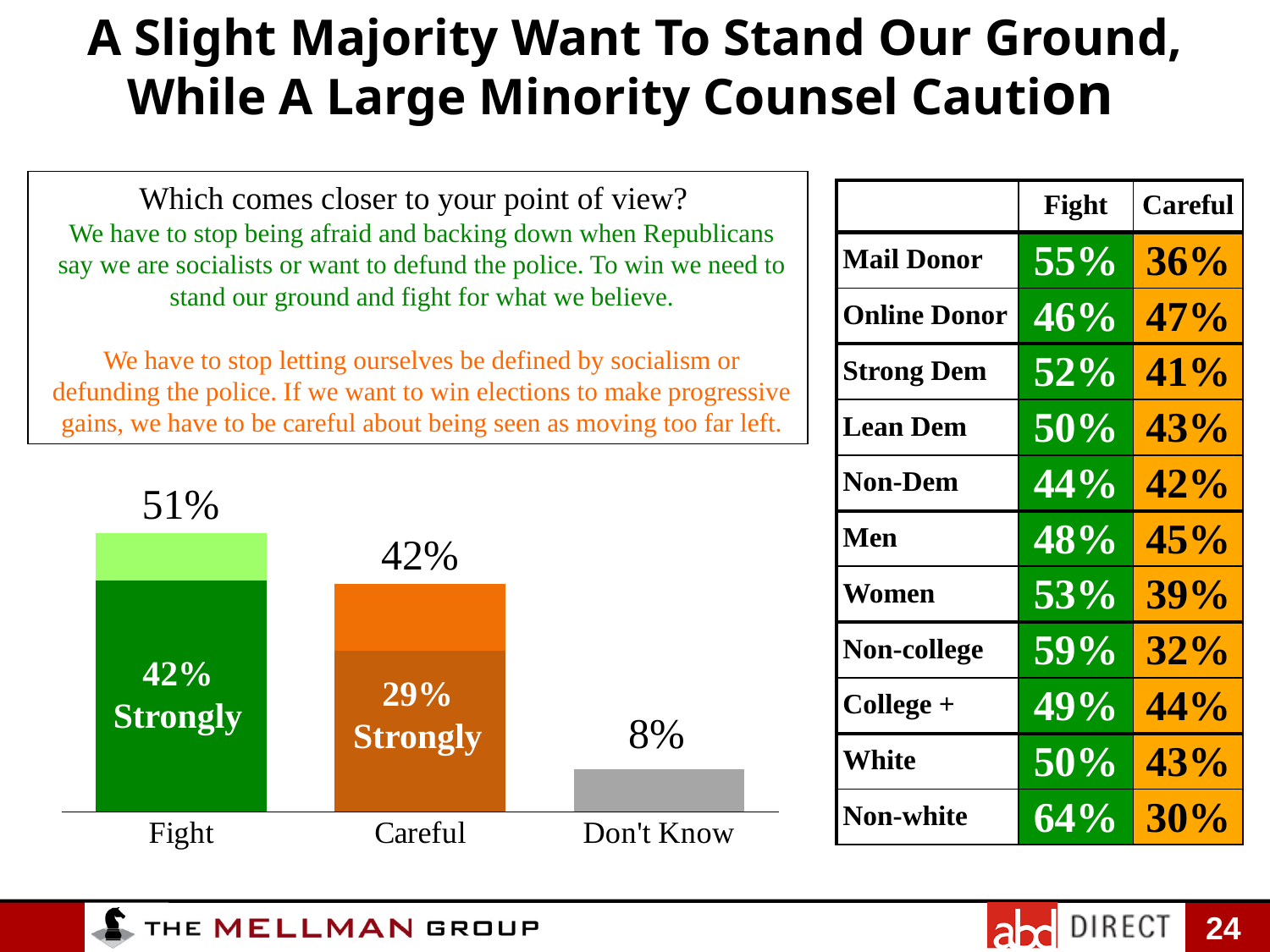
How many categories are shown on the x axis of the bar chart? 3 What share of respondents say 'Strongly' within the Fight bar? 42% Which category has the lowest value in the bar chart? Don't Know What is the difference between the Fight total and the Careful total? 9 percentage points What is the total value shown for the Careful bar? 42% What kind of chart is shown on the slide? Bar chart What is the total value shown for the Fight bar? 51% What is the difference between the 'Strongly' portion of Fight and the 'Strongly' portion of Careful? 13 percentage points What value is shown for Don't Know? 8% Which category has the highest total value in the bar chart? Fight Which is larger, the total for Fight or the total for Careful? Fight What share of respondents say 'Strongly' within the Careful bar? 29%